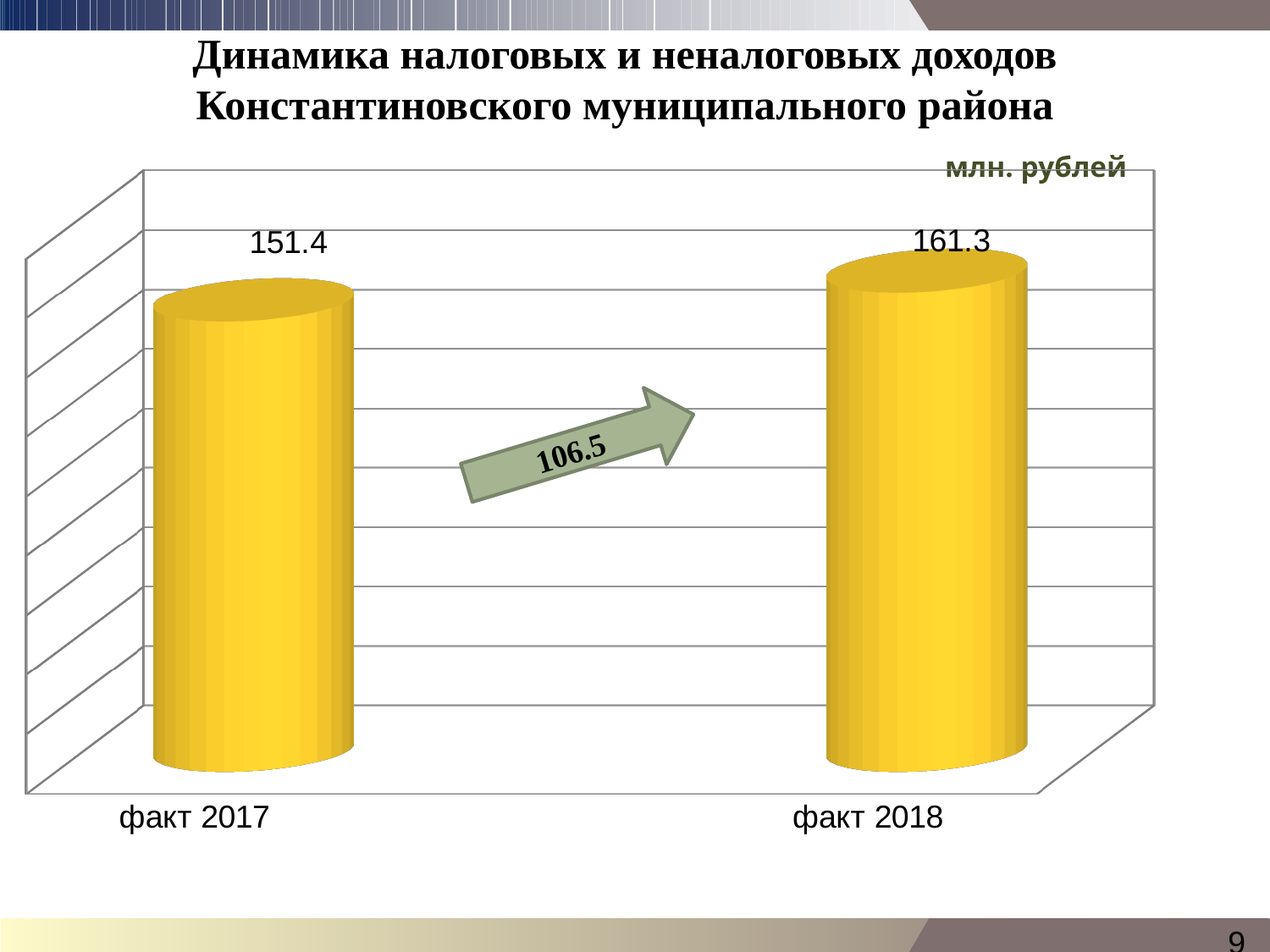
Which category has the lowest value? факт 2017 Which category has the highest value? факт 2018 What is the value for факт 2017? 151.4 What unit is indicated in the top right corner of the chart? млн. рублей What is the difference between the values for факт 2018 and факт 2017? 9.9 What is the value for факт 2018? 161.3 What kind of chart is shown on the slide? bar chart Which is larger, the value for факт 2017 or факт 2018? факт 2018 What number is written on the arrow between the two bars? 106.5 How many categories are shown in the chart? 2 Do the values rise or fall from факт 2017 to факт 2018? rise